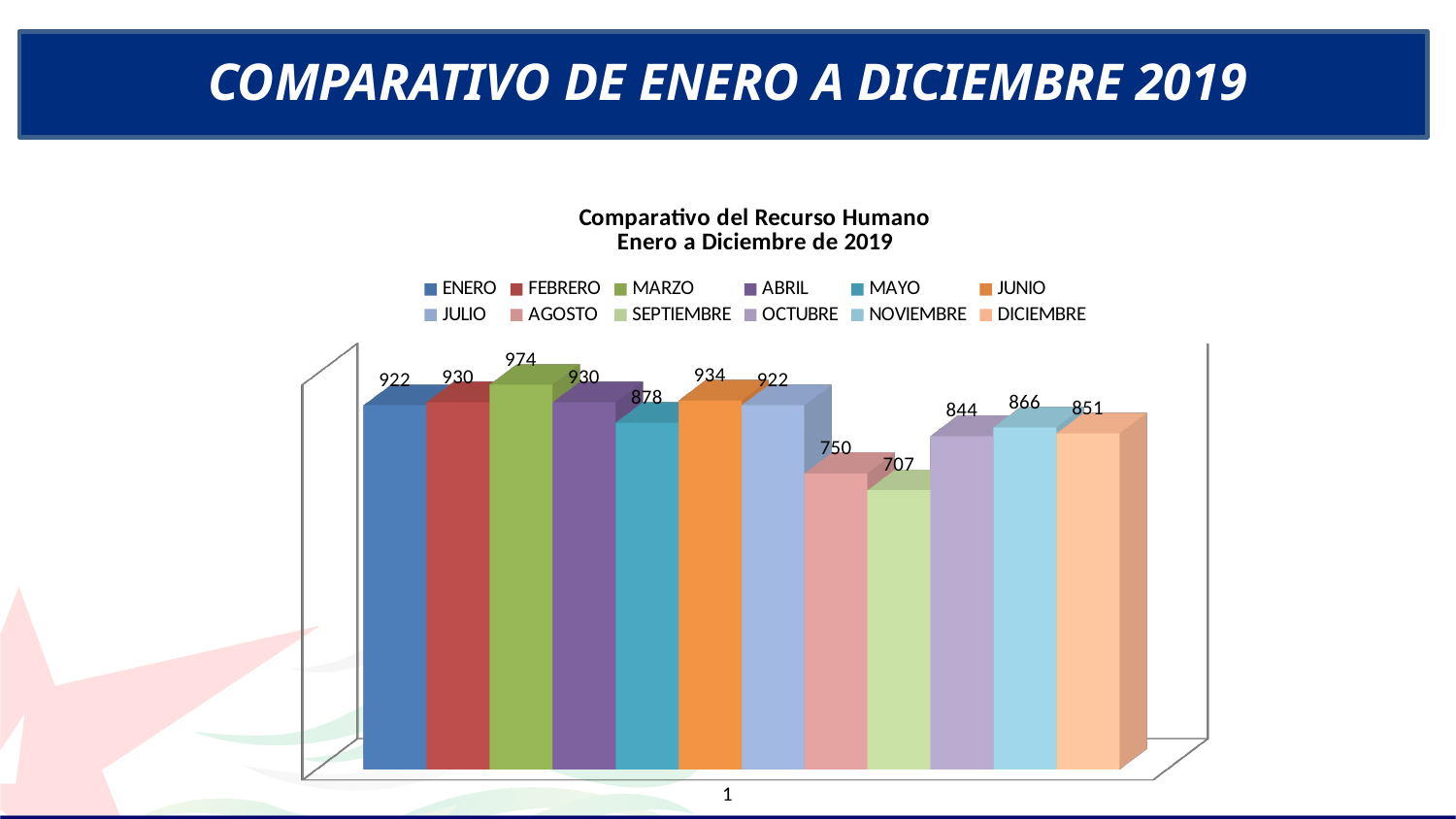
How many series does the legend list? 12 What is the value for NOVIEMBRE? 866 Which month has the highest value? MARZO Which month has the lowest value? SEPTIEMBRE What is the value for MARZO? 974 What is the difference between the values for AGOSTO and SEPTIEMBRE? 43 What is the difference between the values for MARZO and SEPTIEMBRE? 267 What is the value for SEPTIEMBRE? 707 What kind of chart is shown on the slide? Bar chart What is the title of the chart? Comparativo del Recurso Humano Enero a Diciembre de 2019 Which is larger, the value for JUNIO or the value for OCTUBRE? JUNIO What is the value for MAYO? 878